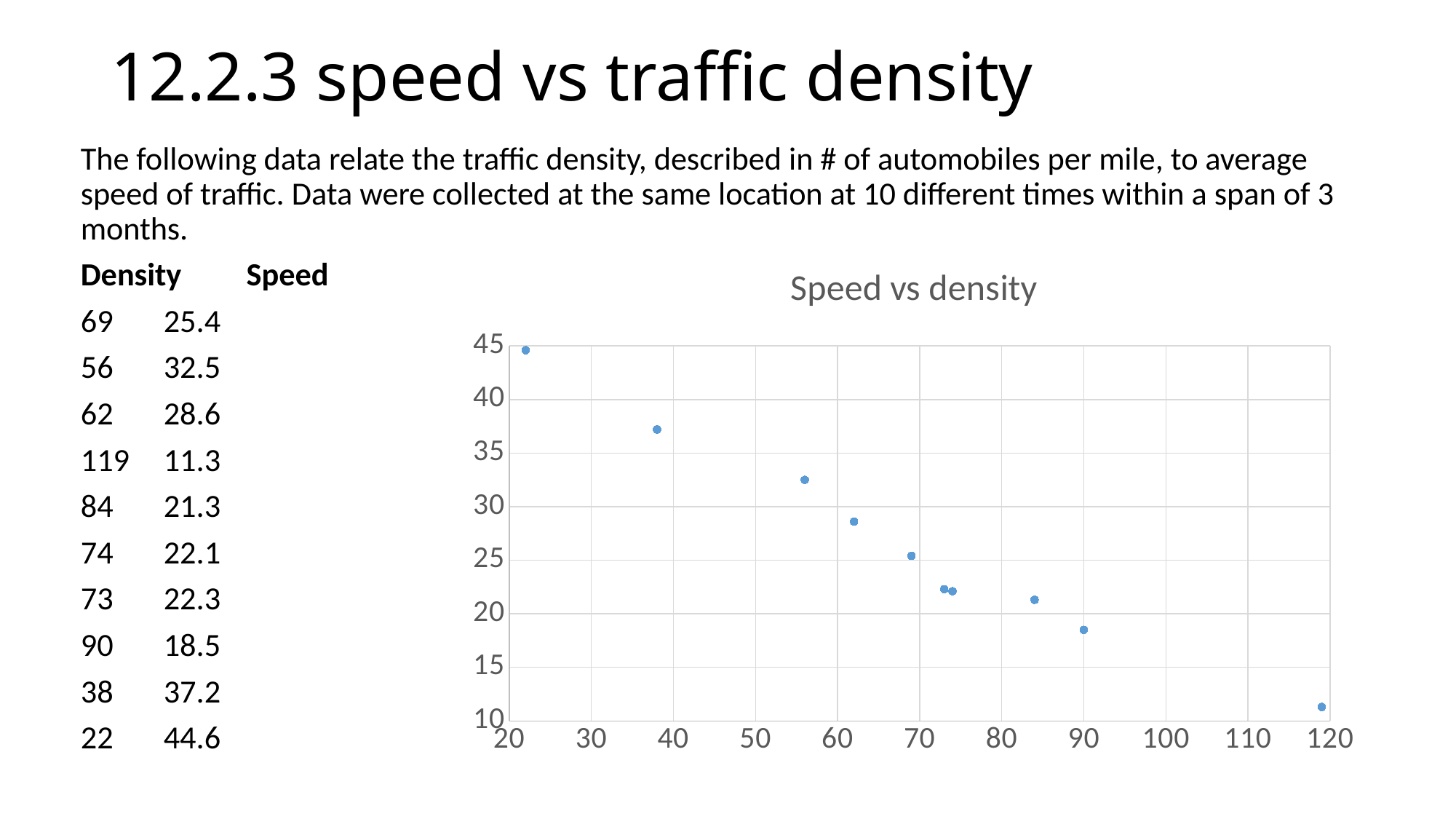
Is the speed at a density of 22 greater or less than 40? greater According to the data on the slide, what is the speed at a density of 62? 28.6 What type of chart is shown on the slide? scatter chart As density increases along the x axis, does speed rise or fall? fall Which density value has the highest speed in the chart? 22 Which density value has the lowest speed in the chart? 119 What is the title of the chart? Speed vs density Is the speed at a density of 84 greater or less than 25? less Is the speed at a density of 119 greater or less than 15? less Which has the higher speed: the point at density 56 or the point at density 90? density 56 How many data points are plotted in the Speed vs density chart? 10